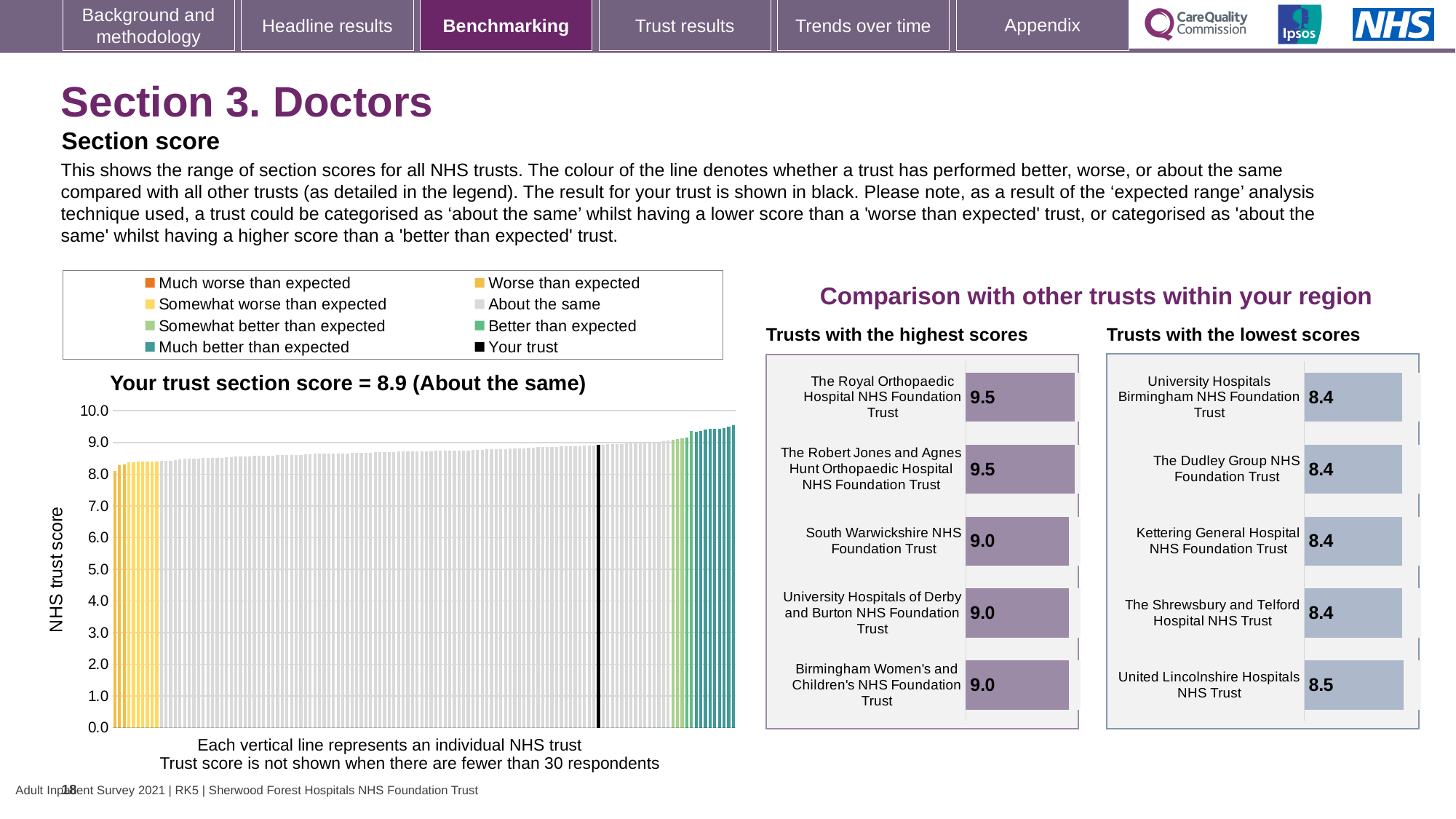
In the chart titled 'Your trust section score = 8.9 (About the same)', how many entries does the legend list? 8 In the chart titled 'Your trust section score = 8.9 (About the same)', what is the section score for your trust? 8.9 In the chart titled 'Your trust section score = 8.9 (About the same)', what kind of chart is shown? bar chart In the chart titled 'Your trust section score = 8.9 (About the same)', is the value of the tallest bar greater or less than 9.0? greater In the chart titled 'Your trust section score = 8.9 (About the same)', what colour is used for 'Your trust' in the legend? black In the chart titled 'Your trust section score = 8.9 (About the same)', what is the label on the vertical axis? NHS trust score In the 'Trusts with the highest scores' chart, what is the difference between the score for The Royal Orthopaedic Hospital NHS Foundation Trust and the score for South Warwickshire NHS Foundation Trust? 0.5 In the 'Trusts with the lowest scores' chart, what is the score for Kettering General Hospital NHS Foundation Trust? 8.4 In the 'Trusts with the highest scores' chart, what is the score for The Royal Orthopaedic Hospital NHS Foundation Trust? 9.5 In the chart titled 'Your trust section score = 8.9 (About the same)', do the bar values rise or fall from left to right along the x axis? rise In the 'Trusts with the lowest scores' chart, which trust has the highest score? United Lincolnshire Hospitals NHS Trust In the 'Trusts with the highest scores' chart, how many trusts are listed? 5